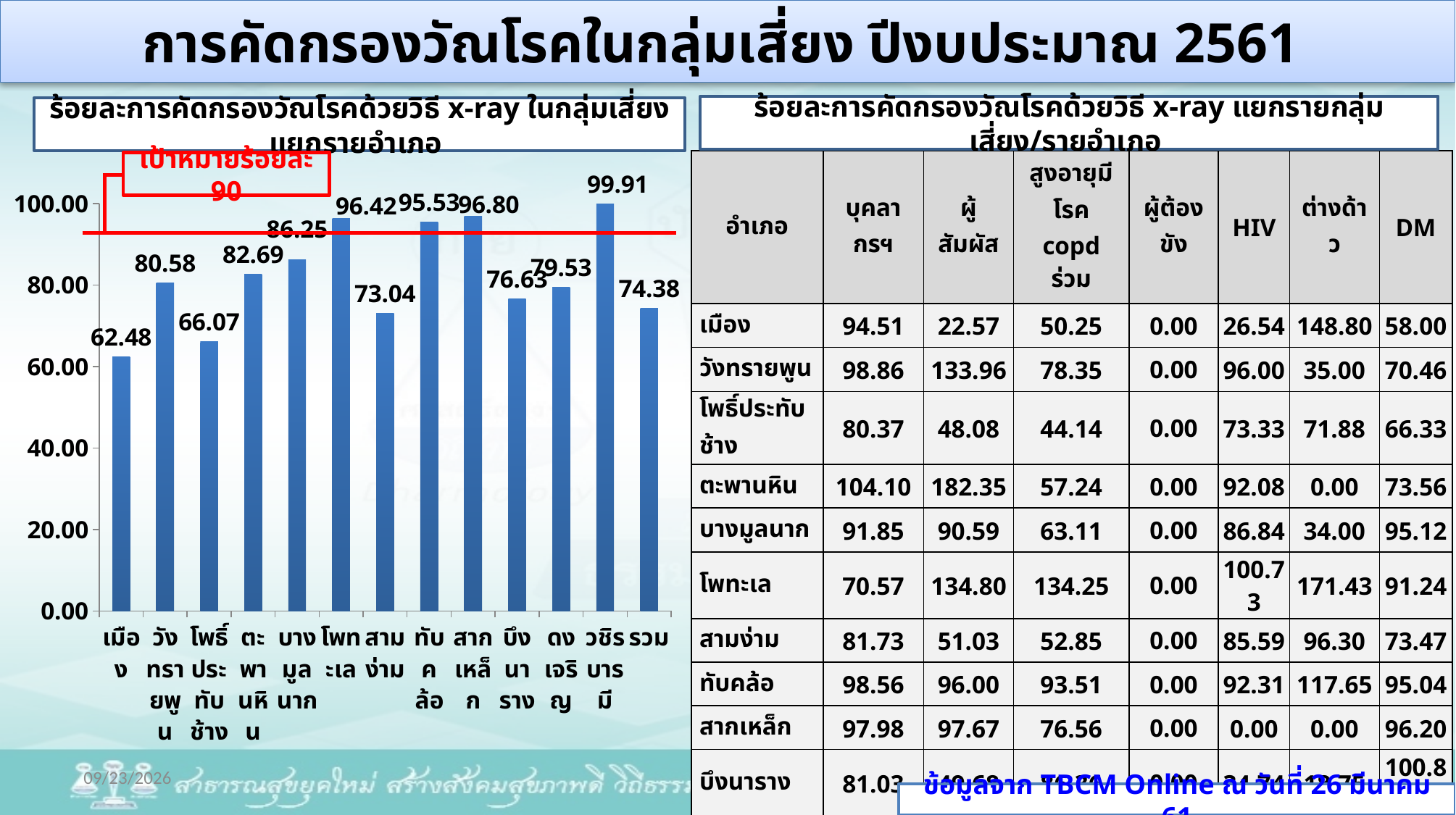
How many bars are plotted in the bar chart? 13 What type of chart is shown on the left side of the slide? bar chart Which district has the highest bar in the bar chart? วชิรบารมี In the bar chart, what is the difference between the values for วชิรบารมี and เมือง? 37.43 Which district has the lowest bar in the bar chart? เมือง What target percentage is marked by the red horizontal line on the bar chart? 90 In the bar chart, what is the value for สามง่าม? 73.04 In the bar chart, what is the value for รวม? 74.38 In the bar chart, what is the value for เมือง? 62.48 In the bar chart, which is larger: the value for ตะพานหิน or the value for บางมูลนาก? บางมูลนาก In the bar chart, is the value for ดงเจริญ greater or less than 80? less In the bar chart, what is the value for วชิรบารมี? 99.91